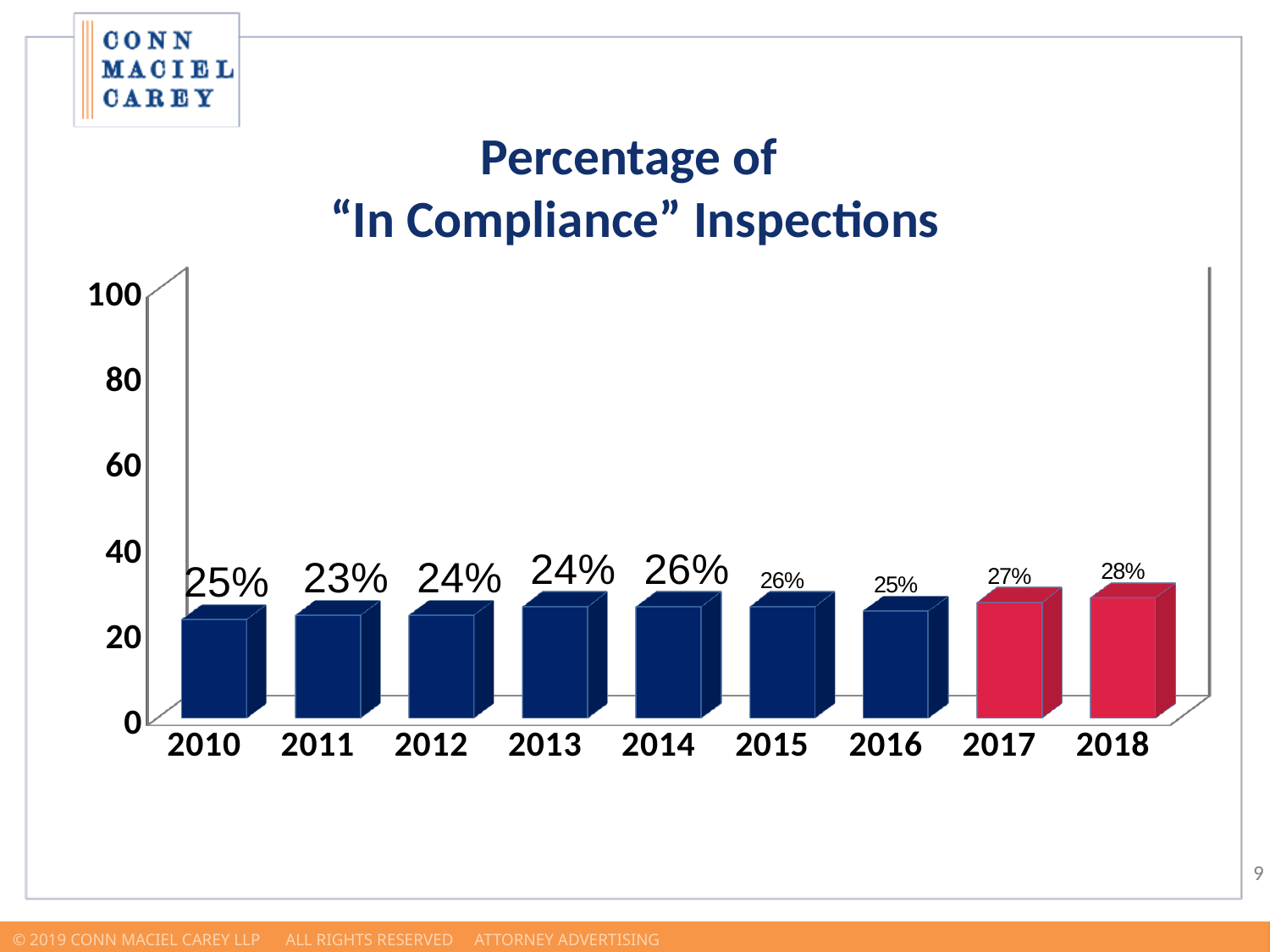
What is the value for 2017? 27% How many years are shown on the x axis? 9 Which year has the highest percentage of "In Compliance" inspections? 2018 What is the difference between the values for 2018 and 2011? 5% What is the value for 2011? 23% Which is larger, the value for 2014 or the value for 2016? 2014 What is the value for 2018? 28% Which years are shown with red bars instead of blue? 2017 and 2018 What kind of chart is shown on the slide? bar chart What is the value for 2010? 25% Is the value for 2015 greater or less than 40? less Which year has the lowest percentage of "In Compliance" inspections? 2011